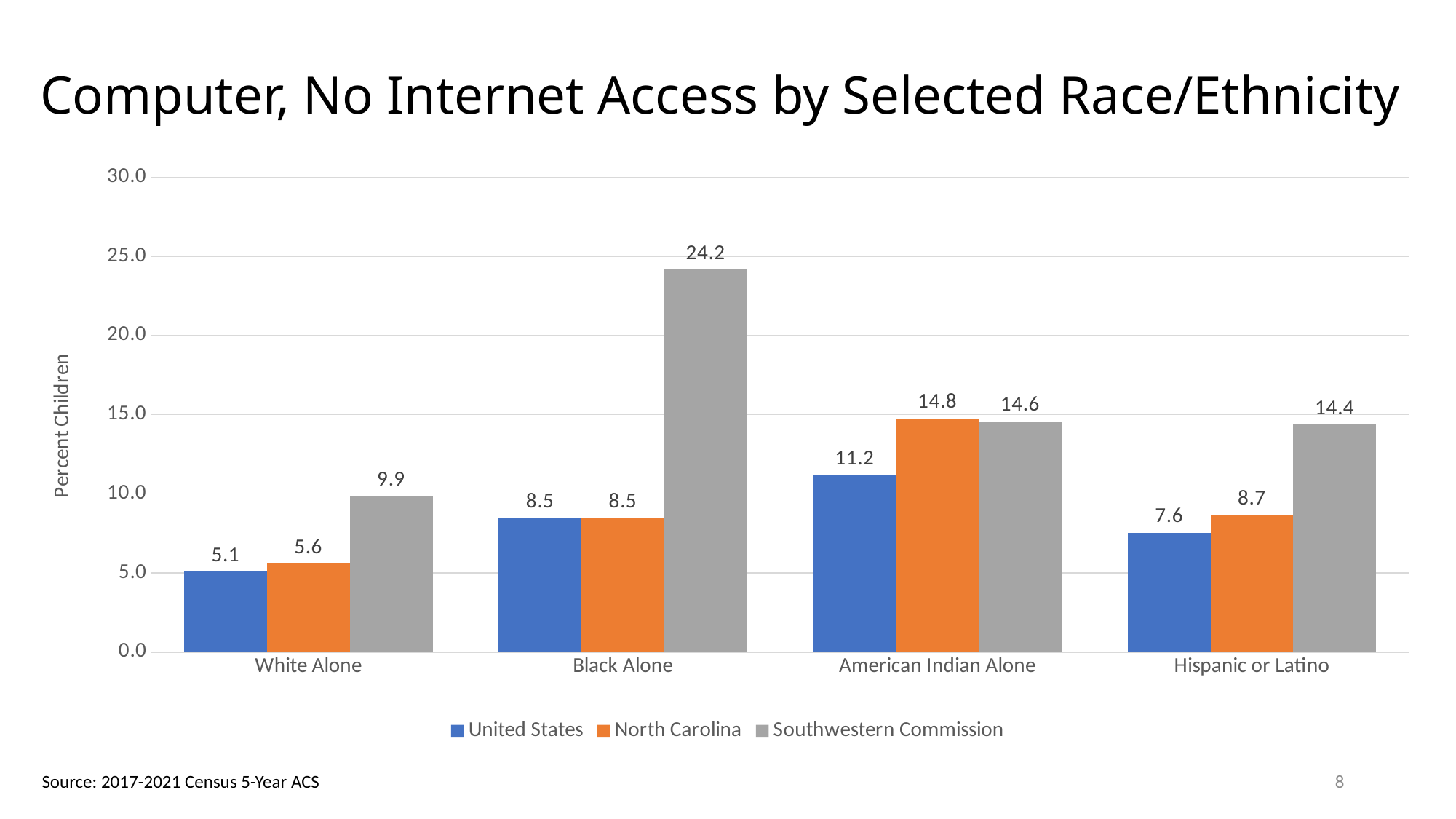
Is the Southwestern Commission value for White Alone greater or less than 10.0? less What is the difference between the Southwestern Commission and United States values for Black Alone? 15.7 Which category has the lowest United States value? White Alone What is the label of the y axis? Percent Children Which category has the highest Southwestern Commission value? Black Alone What is the value for United States in the American Indian Alone category? 11.2 How many race/ethnicity categories are shown on the x axis? 4 How many series does the legend list? 3 What is the value for Southwestern Commission in the Black Alone category? 24.2 What is the value for North Carolina in the Hispanic or Latino category? 8.7 What kind of chart is shown on the slide? bar chart Which is larger for Hispanic or Latino: the North Carolina value or the Southwestern Commission value? Southwestern Commission